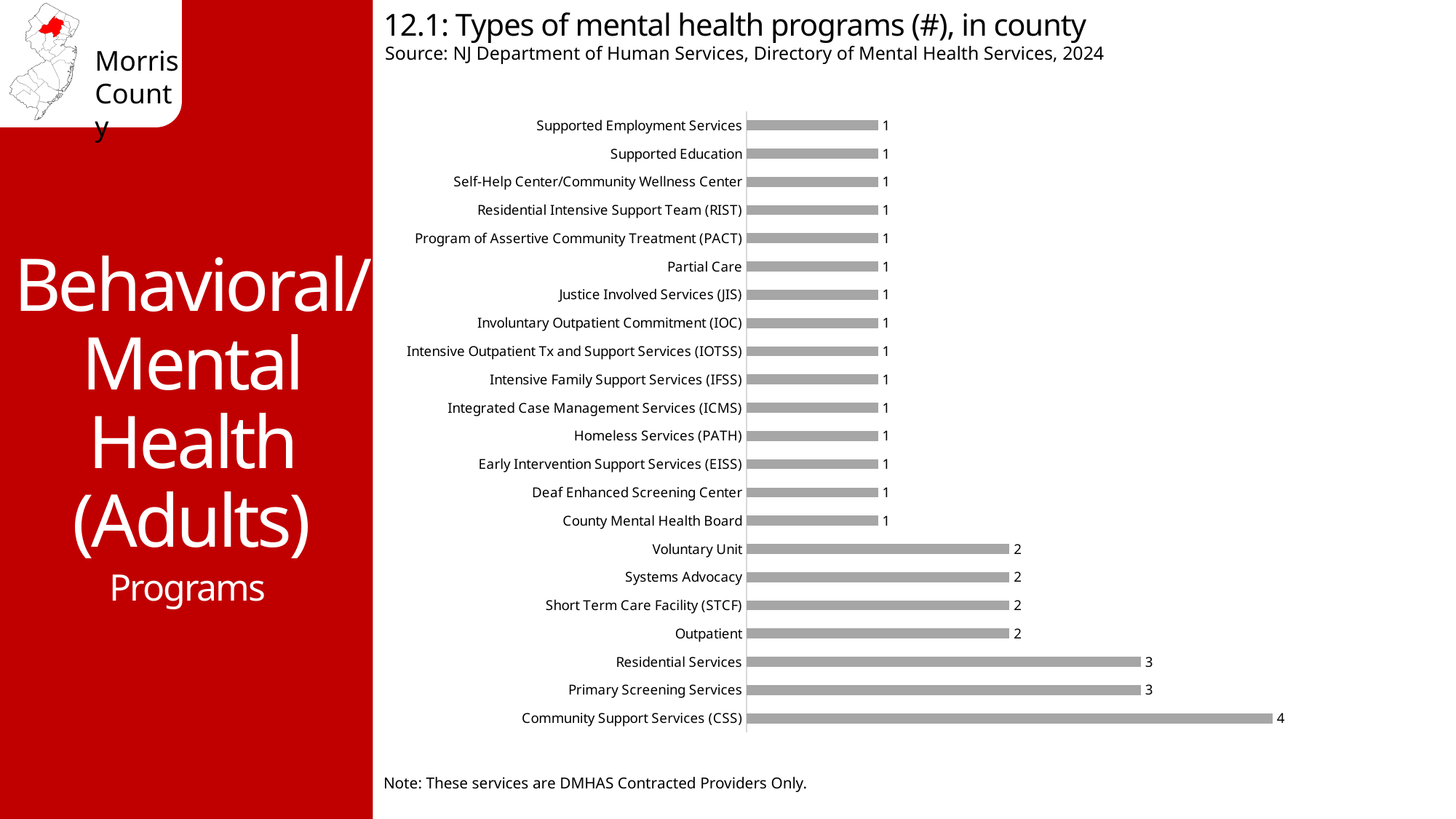
What kind of chart is shown on the slide? Bar chart How many categories are shown in the chart? 22 Which category has the highest value? Community Support Services (CSS) What is the value for Partial Care? 1 Which is larger, Primary Screening Services or Short Term Care Facility (STCF)? Primary Screening Services Which is larger, Systems Advocacy or Homeless Services (PATH)? Systems Advocacy What is the title of the chart? 12.1: Types of mental health programs (#), in county What is the value for Outpatient? 2 What is the value for Residential Services? 3 What is the difference between Community Support Services (CSS) and Primary Screening Services? 1 What is the value for Community Support Services (CSS)? 4 What is the difference between Residential Services and Voluntary Unit? 1